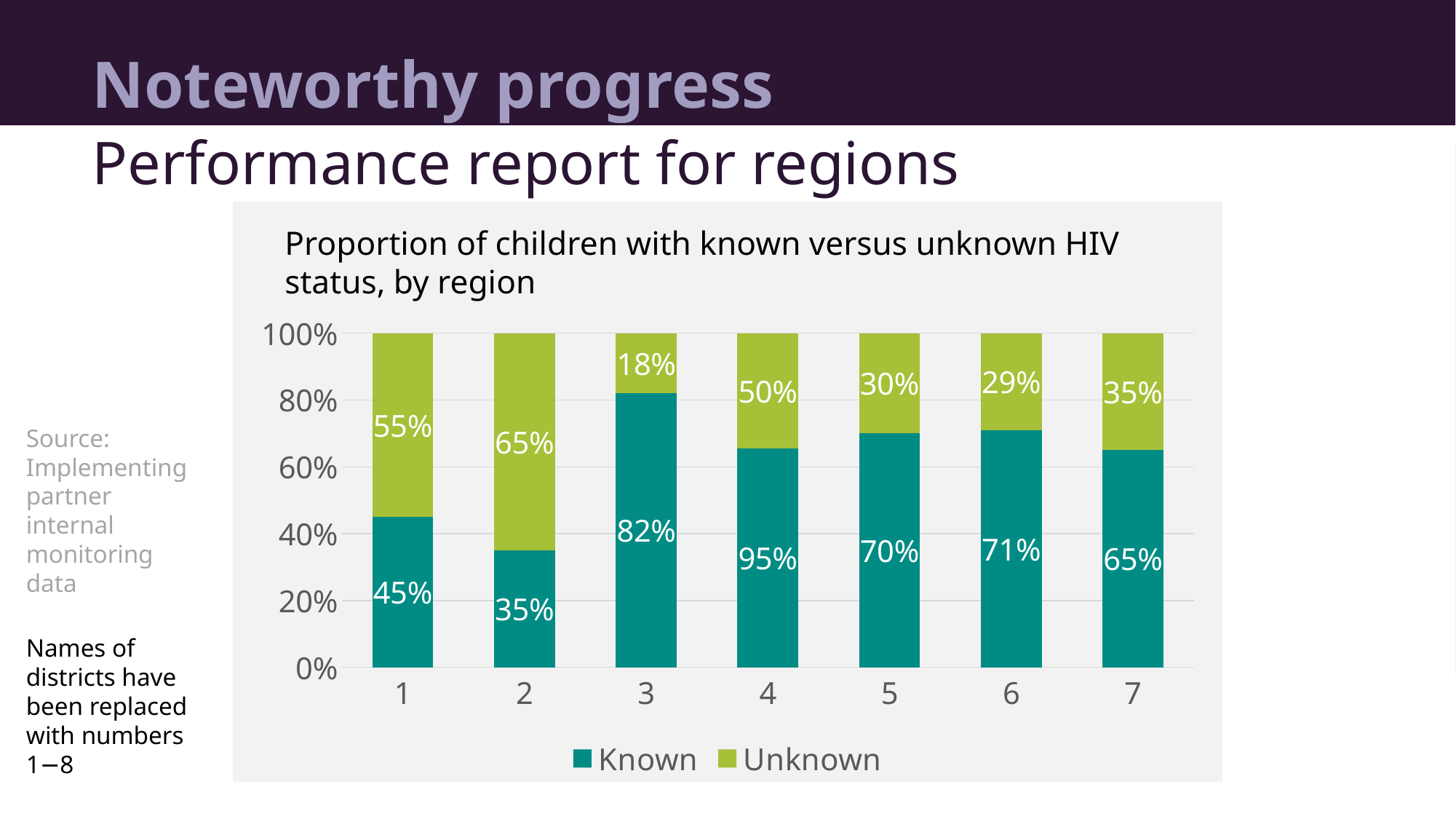
What kind of chart is shown? Stacked bar chart Which region has the larger Known value, region 1 or region 7? 7 How many regions are shown on the x axis? 7 Which region has the highest Unknown value? 2 What is the difference between the Known values for region 3 and region 1? 37 percentage points What is the Unknown value for region 6? 29% What is the Known value for region 3? 82% What is the Known value for region 1? 45% How many series does the legend list? 2 Which region has the lowest Known value? 2 What is the Unknown value for region 2? 65% Which region has the lowest Unknown value? 3